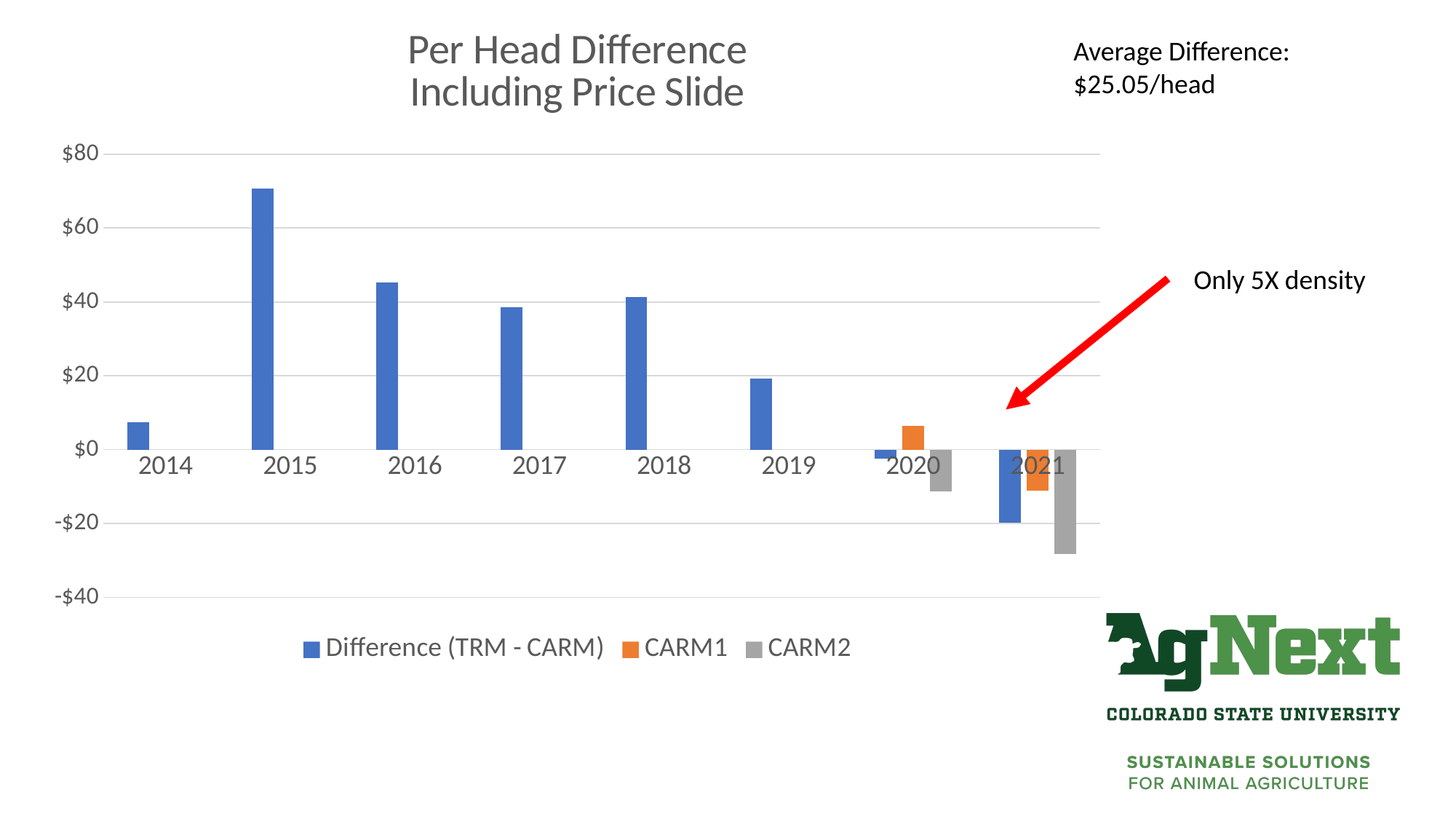
What is the title of the chart? Per Head Difference Including Price Slide Is the Difference (TRM - CARM) value for 2014 greater or less than $20? less How many years are shown on the x axis? 8 What average difference per head is stated on the slide? $25.05/head Which is larger, the Difference (TRM - CARM) value for 2016 or for 2017? 2016 How many series does the legend list? 3 Which year has the lowest Difference (TRM - CARM) bar? 2021 Is the Difference (TRM - CARM) value for 2015 greater or less than $60? greater Is the CARM2 value for 2021 greater or less than -$20? less Which year has the highest Difference (TRM - CARM) bar? 2015 What kind of chart is shown on the slide? Bar chart